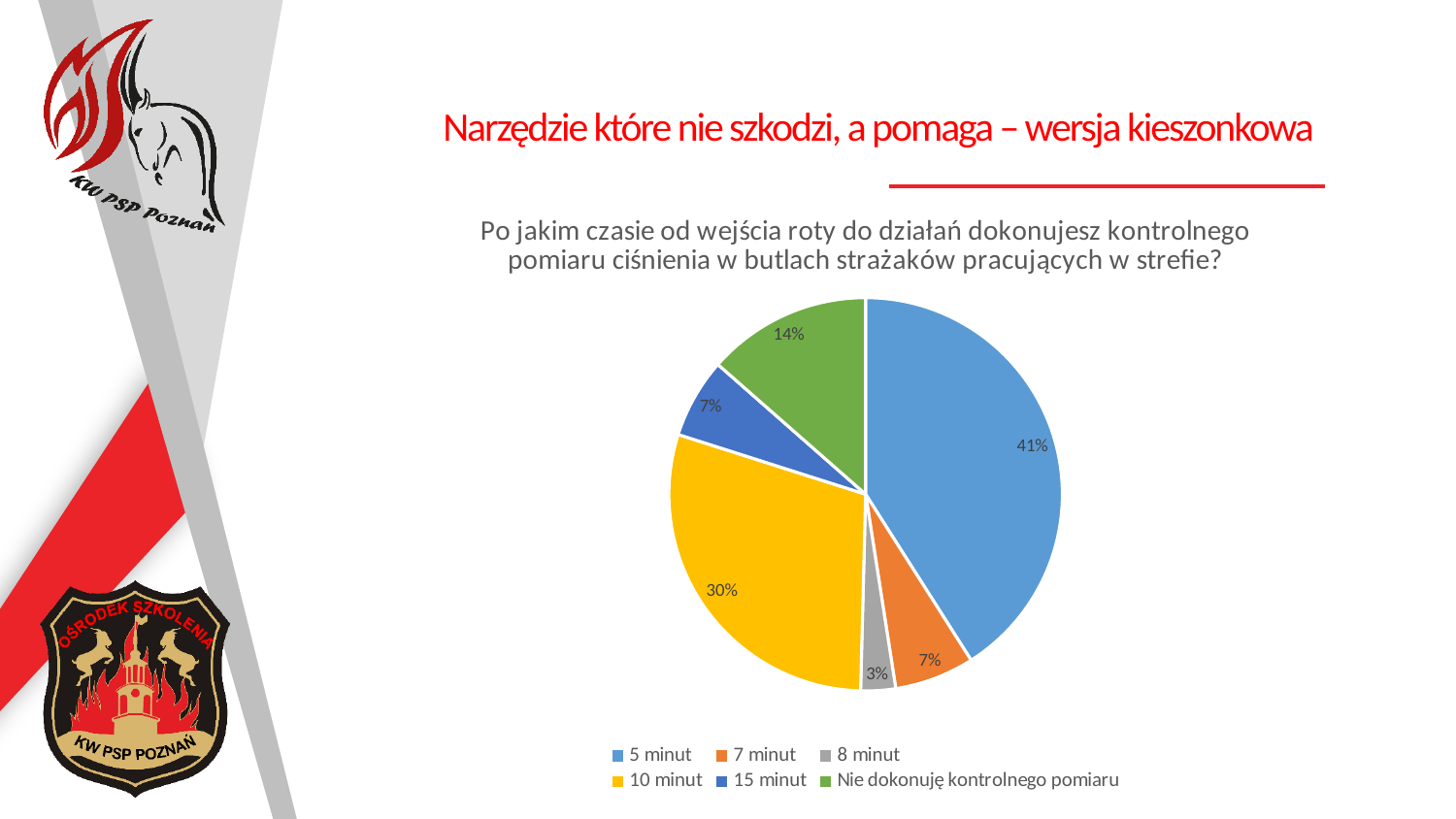
What colour is the slice for "10 minut"? yellow How many categories does the legend of the pie chart list? 6 What share of respondents answered "15 minut"? 7% What type of chart is shown on the slide? pie chart What share of respondents answered "5 minut"? 41% What is the difference in percentage points between the "5 minut" and "10 minut" slices? 11 Which is larger, the share for "10 minut" or the share for "Nie dokonuję kontrolnego pomiaru"? 10 minut Which answer has the largest share of the pie? 5 minut What share of respondents answered "10 minut"? 30% Which answer has the smallest share of the pie? 8 minut What share of respondents answered "Nie dokonuję kontrolnego pomiaru"? 14% What share of respondents answered "8 minut"? 3%